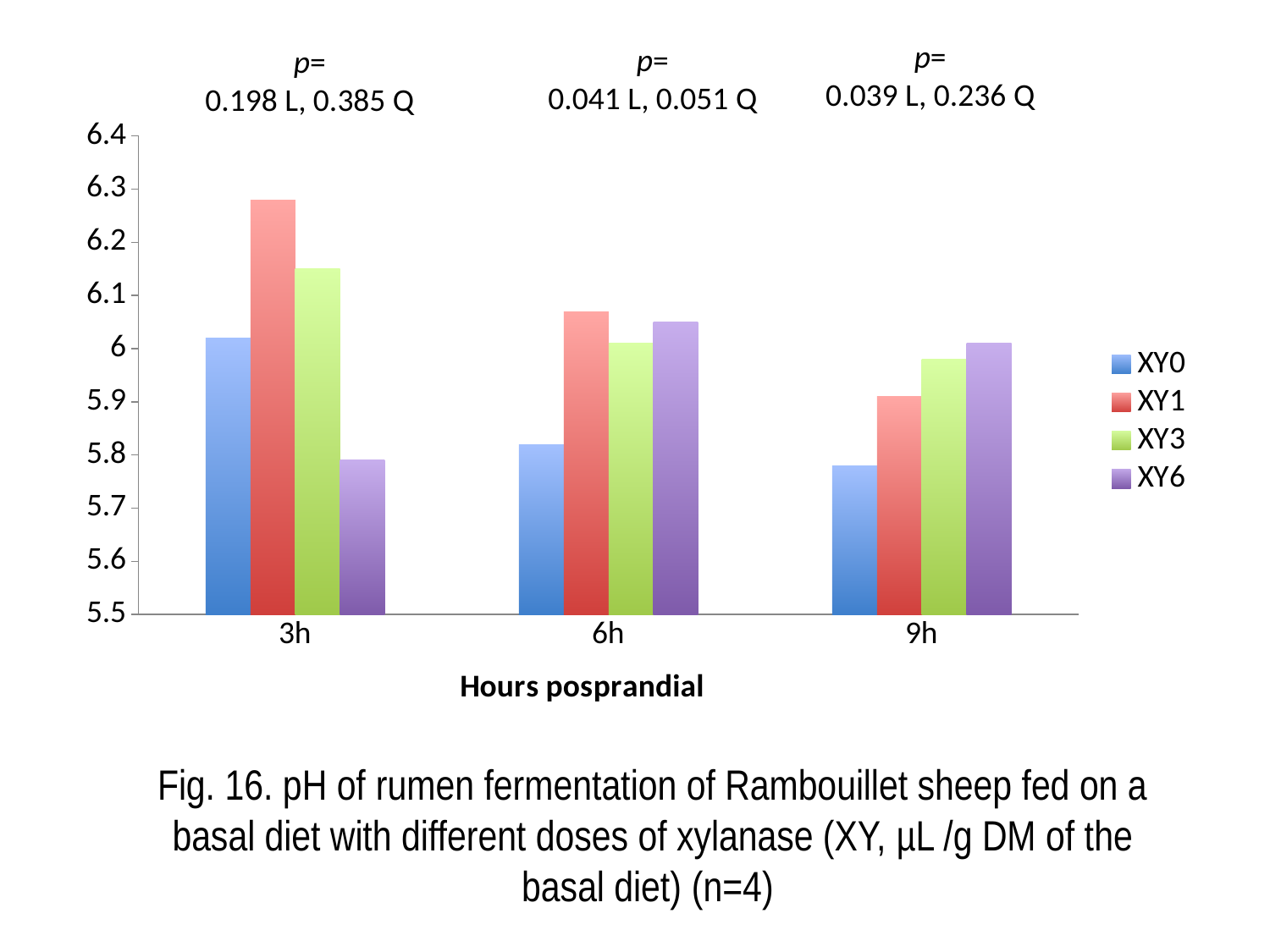
Is the value for XY0 at 6h greater or less than 5.9? less What is the title of the x axis? Hours posprandial How many categories are shown on the x axis? 3 Which series has the highest value at 3h? XY1 Which is larger: the value for XY1 at 3h or the value for XY1 at 9h? XY1 at 3h Is the value for XY1 at 3h greater or less than 6.2? greater What kind of chart is shown on the slide? bar chart How many series does the legend list? 4 Which series has the lowest value at 3h? XY6 Do the values for XY0 rise or fall from 3h to 9h? fall Is the value for XY3 at 3h greater or less than 6.1? greater Which series has the lowest value at 6h? XY0